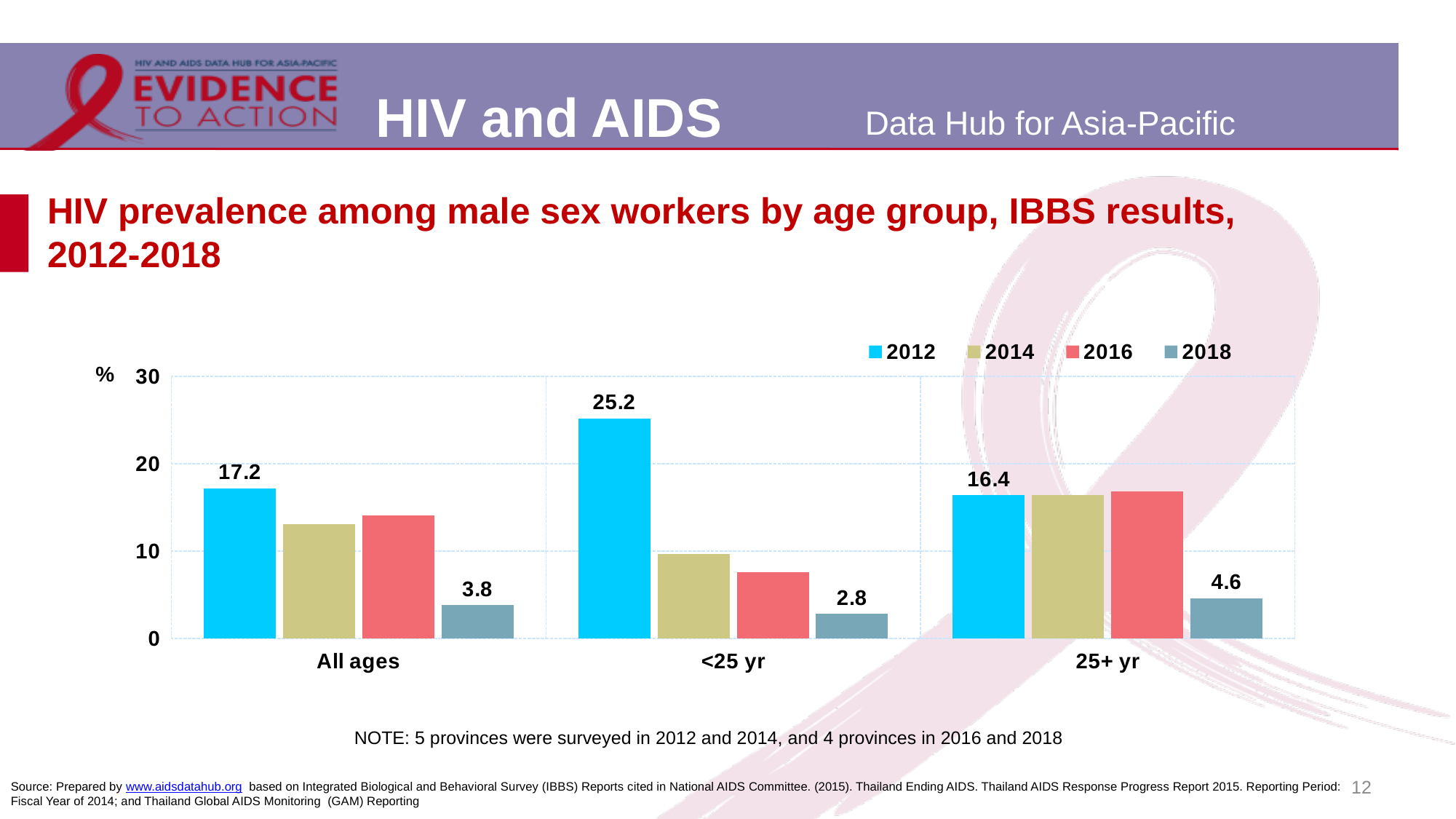
What is the difference between the 2012 values for the <25 yr group and the 25+ yr group? 8.8 How many age group categories are shown on the x axis? 3 What is the value for the 25+ yr group in 2018? 4.6 Which age group has the highest value in the 2012 series? <25 yr In the All ages group, which is larger: the 2012 value or the 2018 value? 2012 How many series does the legend list? 4 Is the value for the 2016 series in the All ages group greater or less than 10? greater What is the value for the 2018 series in the All ages group? 3.8 What kind of chart is shown on the slide? Bar chart Which age group has the lowest value in the 2018 series? <25 yr What is the HIV prevalence for the <25 yr group in 2012? 25.2 What is the value for the 25+ yr group in 2012? 16.4